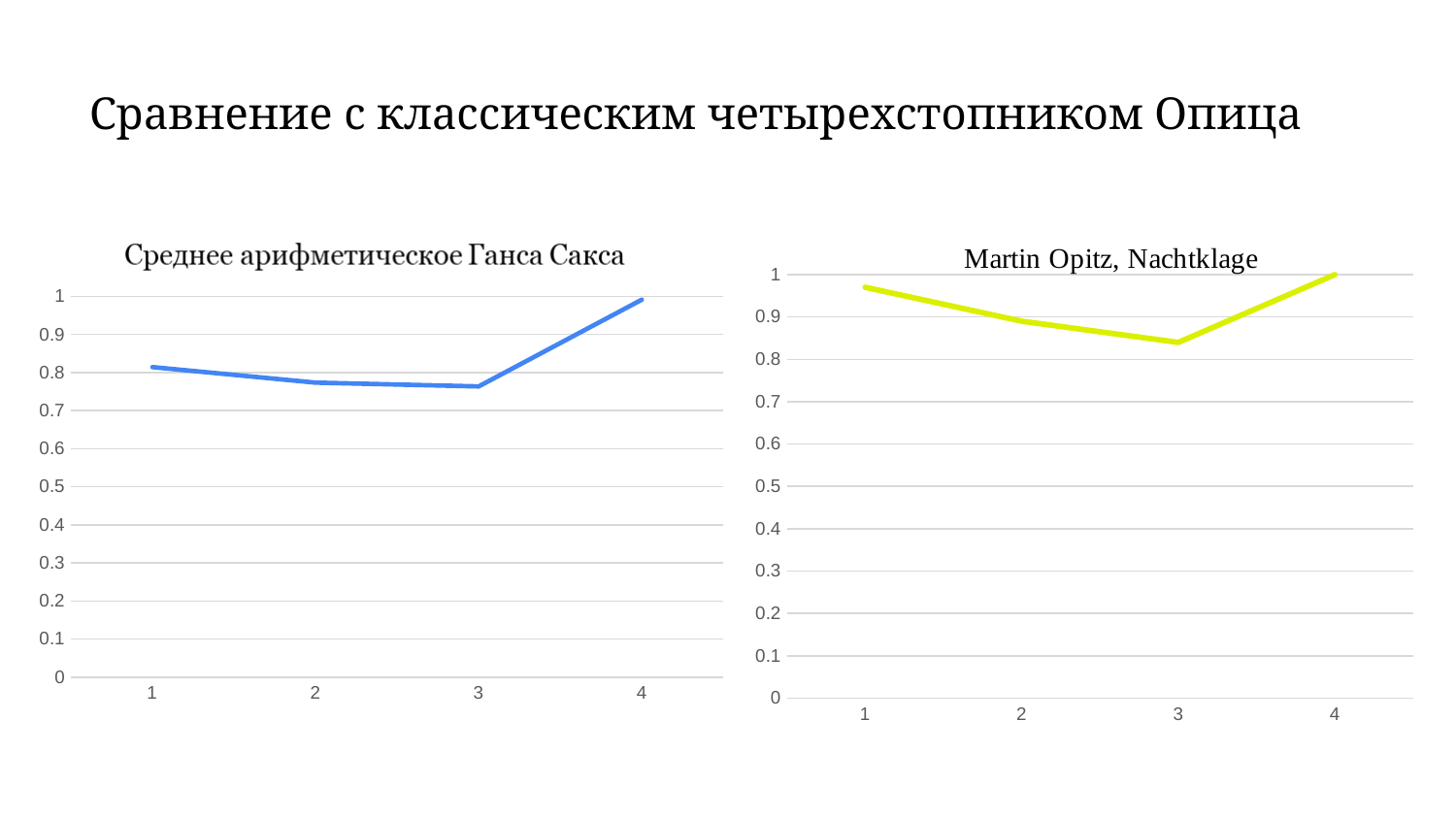
What kind of chart is the chart titled "Среднее арифметическое Ганса Сакса"? line chart In the chart titled "Среднее арифметическое Ганса Сакса", is the value at position 2 greater or less than 0.8? less What kind of chart is the chart titled "Martin Opitz, Nachtklage"? line chart In the chart titled "Среднее арифметическое Ганса Сакса", at which x-axis position is the value highest? 4 In the chart titled "Martin Opitz, Nachtklage", is the value at position 3 greater or less than 0.8? greater In the chart titled "Martin Opitz, Nachtklage", at which x-axis position is the value lowest? 3 In the chart titled "Среднее арифметическое Ганса Сакса", how many points are plotted along the x axis? 4 In the chart titled "Martin Opitz, Nachtklage", is the value at position 1 greater or less than 0.9? greater In the chart titled "Среднее арифметическое Ганса Сакса", which is larger, the value at position 1 or the value at position 4? position 4 In the chart titled "Martin Opitz, Nachtklage", how many points are plotted along the x axis? 4 In the chart titled "Martin Opitz, Nachtklage", do the values rise or fall from position 1 to position 3? fall